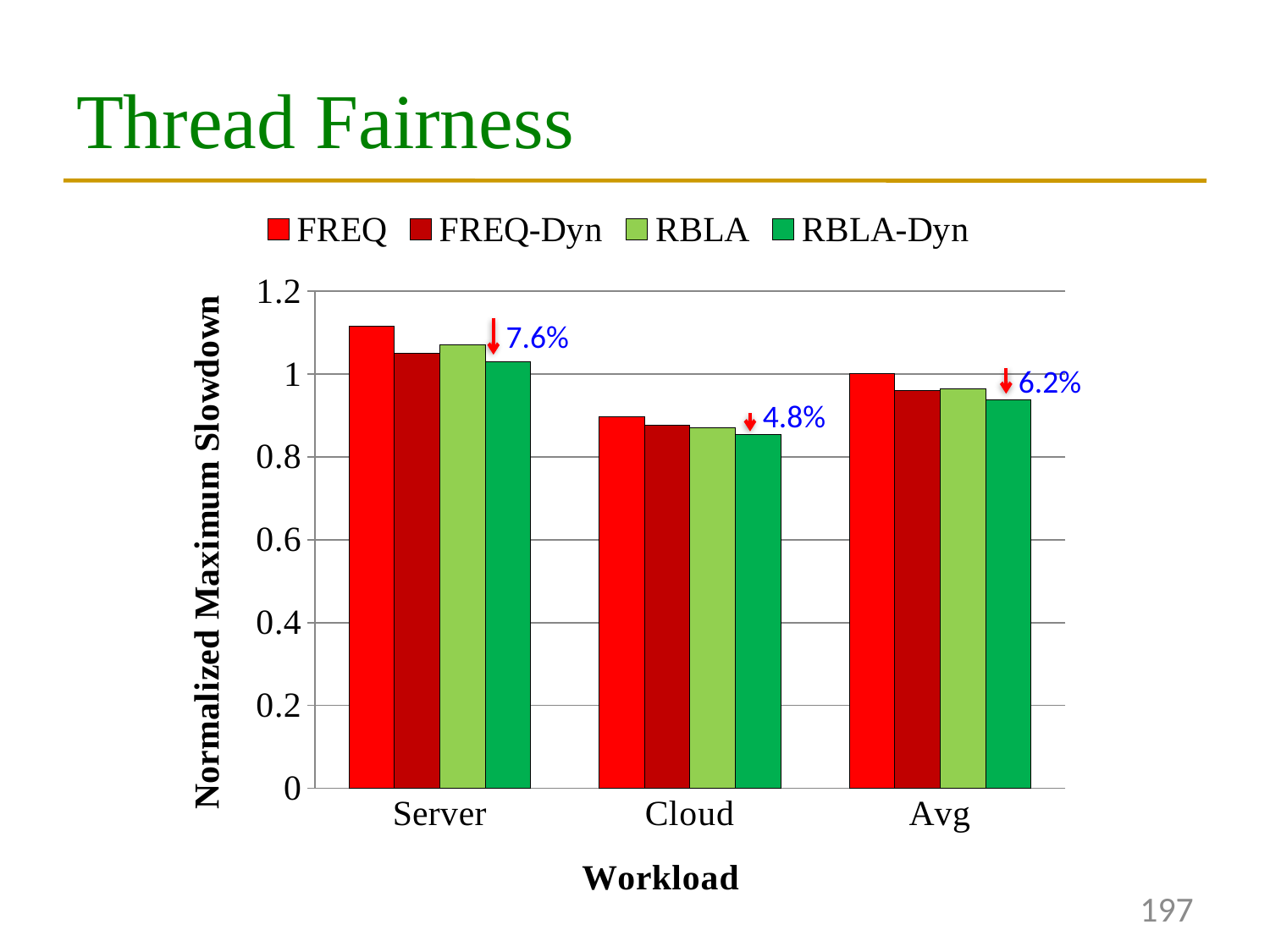
What percentage reduction is annotated above the Server group? 7.6% Is the RBLA-Dyn value for Avg greater or less than 1? less Is the FREQ value for Server greater or less than 1? greater Is the RBLA-Dyn value for Cloud greater or less than 0.8? greater How many workload categories are shown on the x axis? 3 Which workload has the lowest RBLA-Dyn bar? Cloud What is the label of the y axis? Normalized Maximum Slowdown Which is larger, the FREQ value for Server or the FREQ value for Cloud? Server What kind of chart is shown on the slide? bar chart Which is larger for the Server workload, the FREQ bar or the RBLA-Dyn bar? FREQ How many series does the legend list? 4 Which workload has the highest FREQ bar? Server